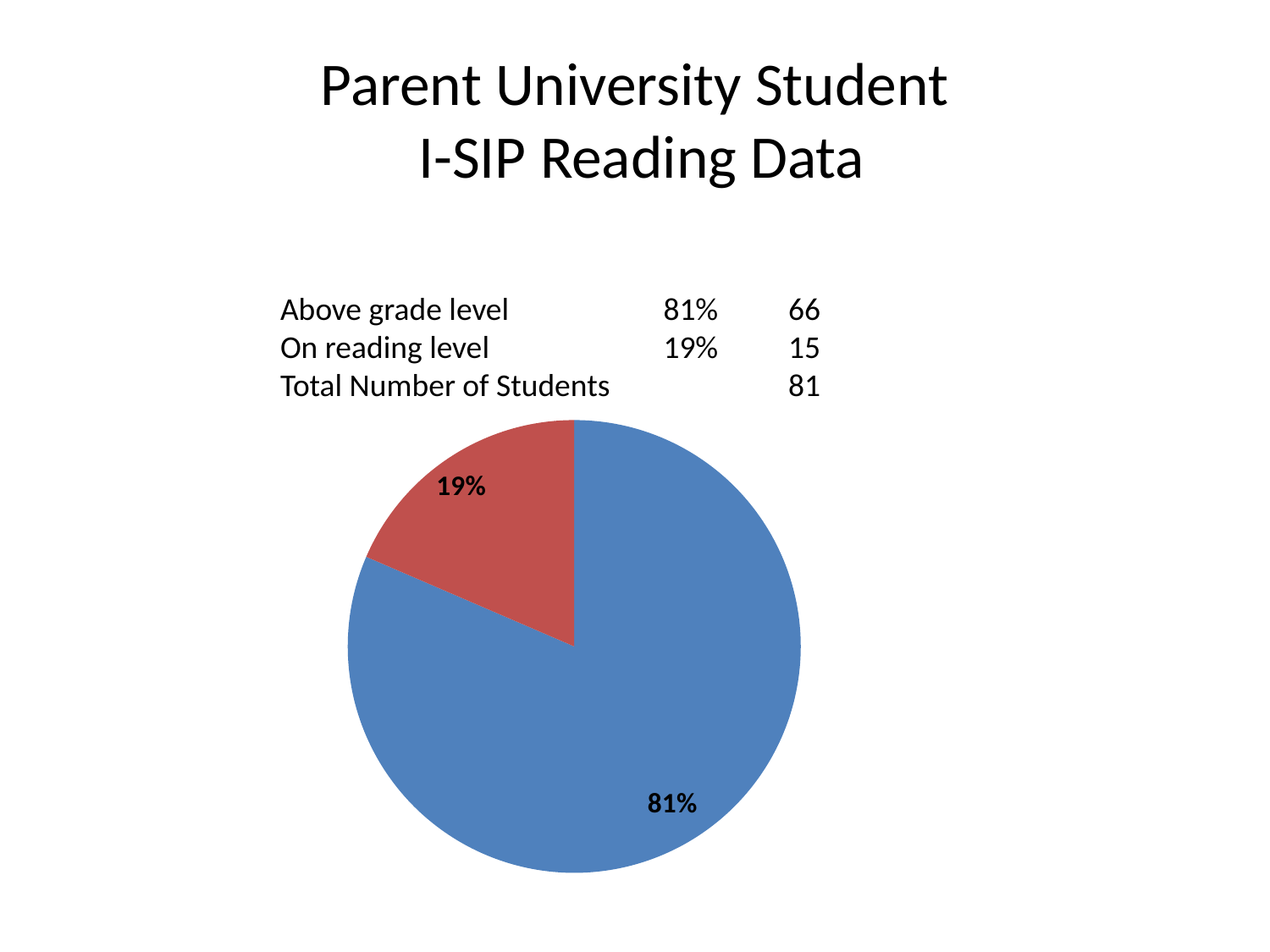
What percentage is shown on the largest slice of the pie chart? 81% What is the Total Number of Students shown on the slide? 81 What is the title of the slide containing the pie chart? Parent University Student I-SIP Reading Data What percentage is shown on the smallest slice of the pie chart? 19% How many slices does the pie chart have? 2 What is the difference in percentage points between the Above grade level share and the On reading level share? 62 Which category has the larger share of the pie, Above grade level or On reading level? Above grade level How many students are On reading level according to the slide? 15 How many students are Above grade level according to the slide? 66 What kind of chart is shown on the slide? Pie chart What share of students are Above grade level according to the slide? 81% What colour is the slice representing 19% of the pie? Red